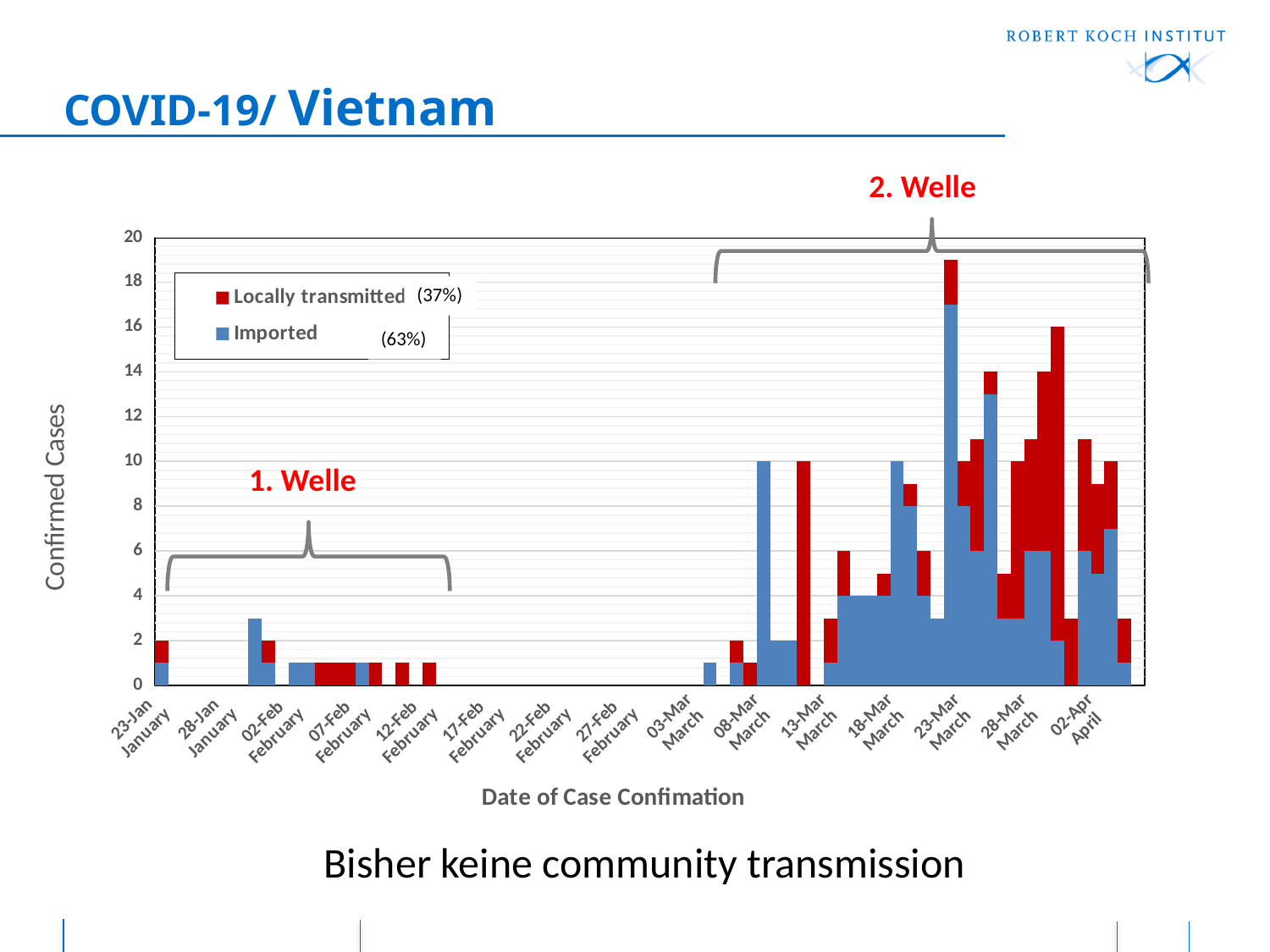
Are the bars in the 2. Welle period generally higher or lower than those in the 1. Welle period? higher Is the value for 08-Mar greater or less than 8? greater How many series does the legend list? 2 What are the two series named in the legend? Locally transmitted, Imported Which wave, 1. Welle or 2. Welle, contains the tallest bar? 2. Welle Is the value for 23-Jan greater or less than 4? less Is the tallest bar in the chart greater or less than 16? greater What kind of chart is shown on the slide? bar chart What percentage is shown next to 'Imported' in the legend? 63%